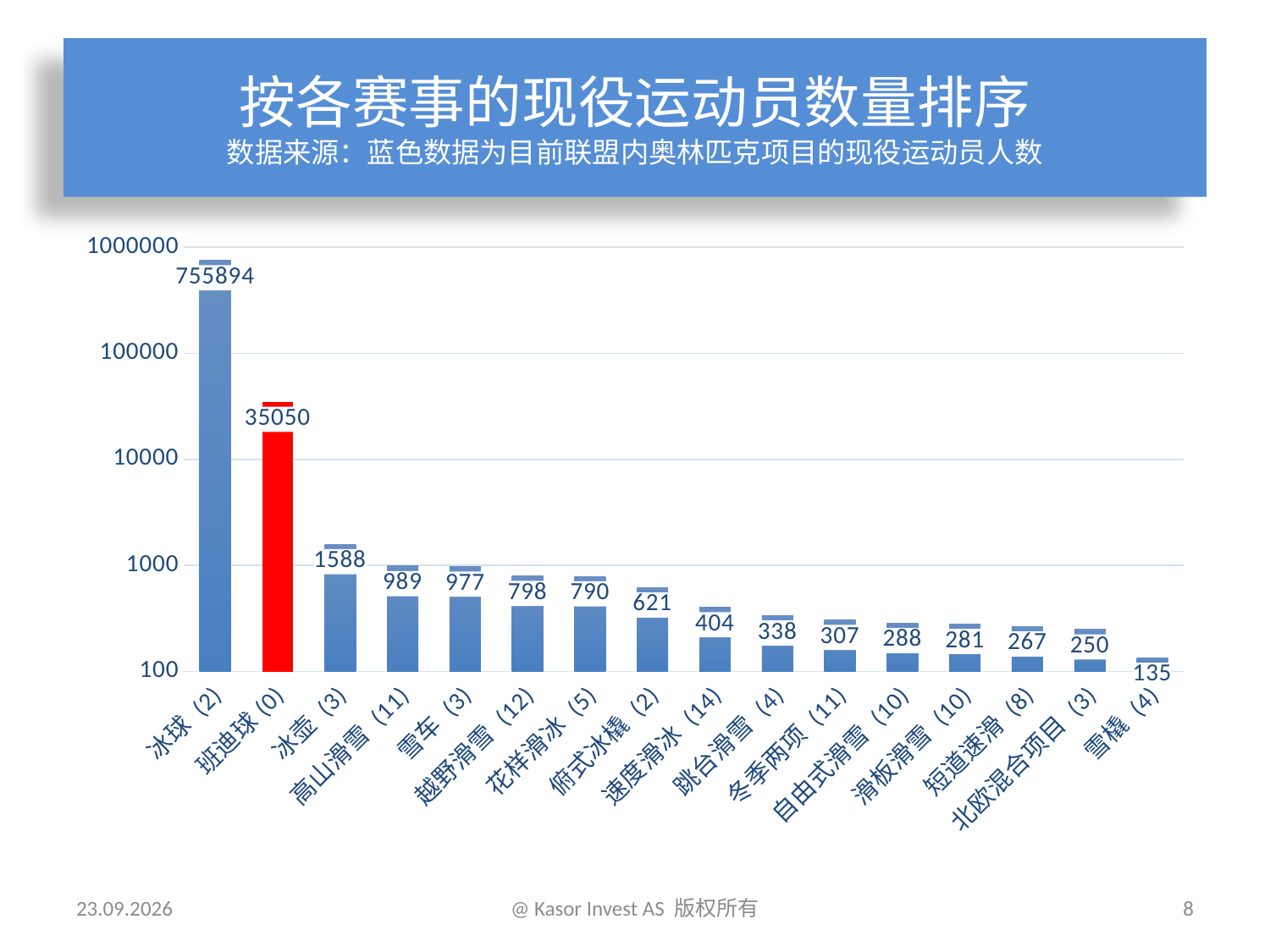
What is the value for 班迪球 (0)? 35050 Which category has the lowest value? 雪橇 (4) What is the difference between the values for 冰壶 (3) and 高山滑雪 (11)? 599 Which is larger, the value for 速度滑冰 (14) or the value for 跳台滑雪 (4)? 速度滑冰 (14) Which bar is coloured red instead of blue? 班迪球 (0) What kind of chart is shown on the slide? bar chart Is the value for 俯式冰橇 (2) greater or less than 1000? less What is the value for 冰球 (2)? 755894 How many categories are shown on the x axis? 16 Which category has the highest value? 冰球 (2) What is the value for 北欧混合项目 (3)? 250 What is the value for 花样滑冰 (5)? 790